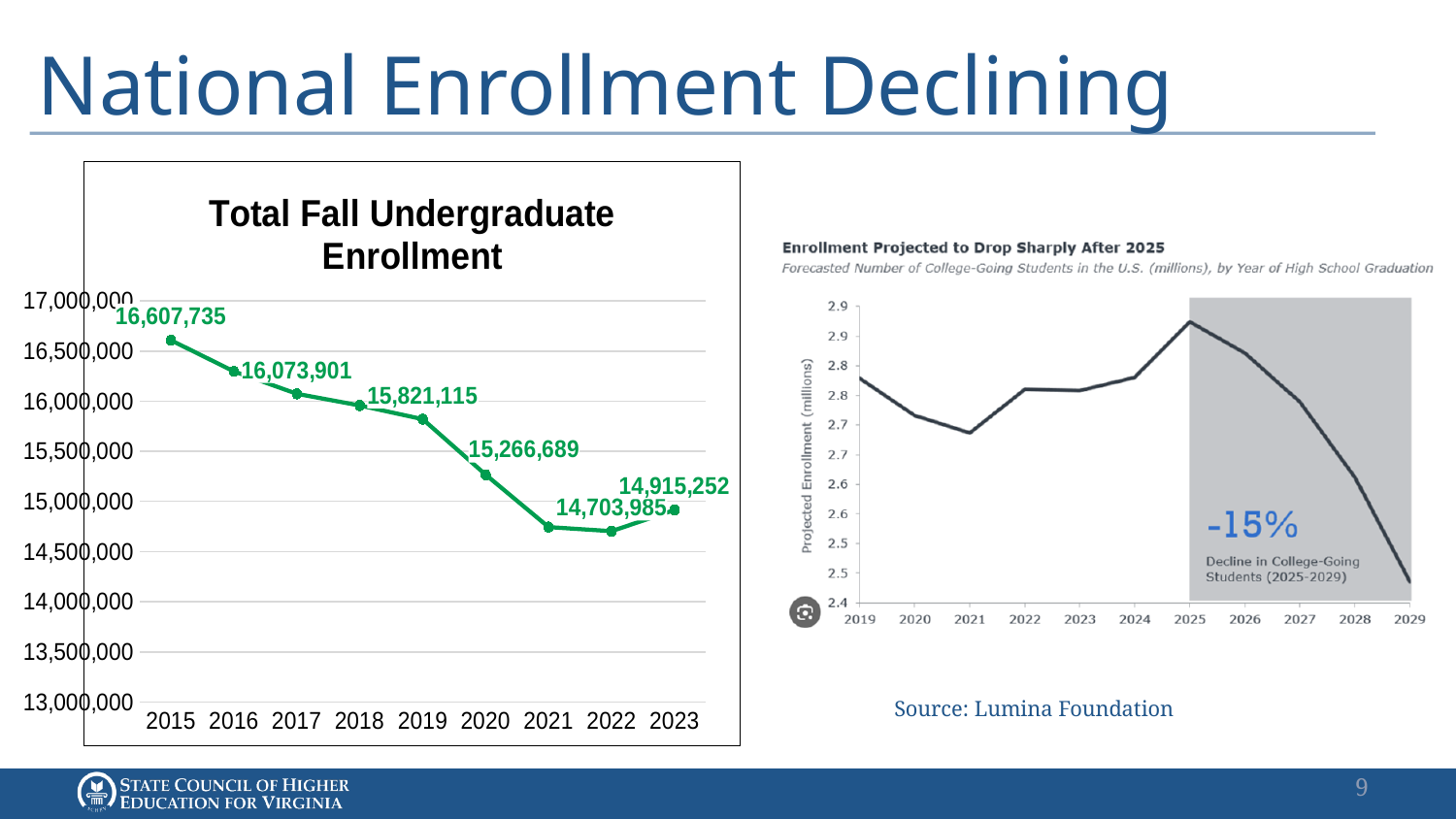
In the Total Fall Undergraduate Enrollment chart, is the value for 2018 greater or less than 15,500,000? greater What kind of chart is the Total Fall Undergraduate Enrollment chart? line chart In the Total Fall Undergraduate Enrollment chart, what was the enrollment in 2023? 14,915,252 What percentage decline in college-going students for 2025-2029 is shown on the Enrollment Projected to Drop Sharply After 2025 chart? -15% In the Total Fall Undergraduate Enrollment chart, which year has the highest enrollment? 2015 How many years are plotted on the x axis of the Total Fall Undergraduate Enrollment chart? 9 In the Total Fall Undergraduate Enrollment chart, do values generally rise or fall from 2015 to 2022? fall In the Total Fall Undergraduate Enrollment chart, what is the difference between the 2015 and 2023 enrollment values? 1,692,483 In the Total Fall Undergraduate Enrollment chart, what was the enrollment in 2020? 15,266,689 In the Total Fall Undergraduate Enrollment chart, what was the enrollment in 2015? 16,607,735 In the Total Fall Undergraduate Enrollment chart, which is larger, the 2015 value or the 2023 value? 2015